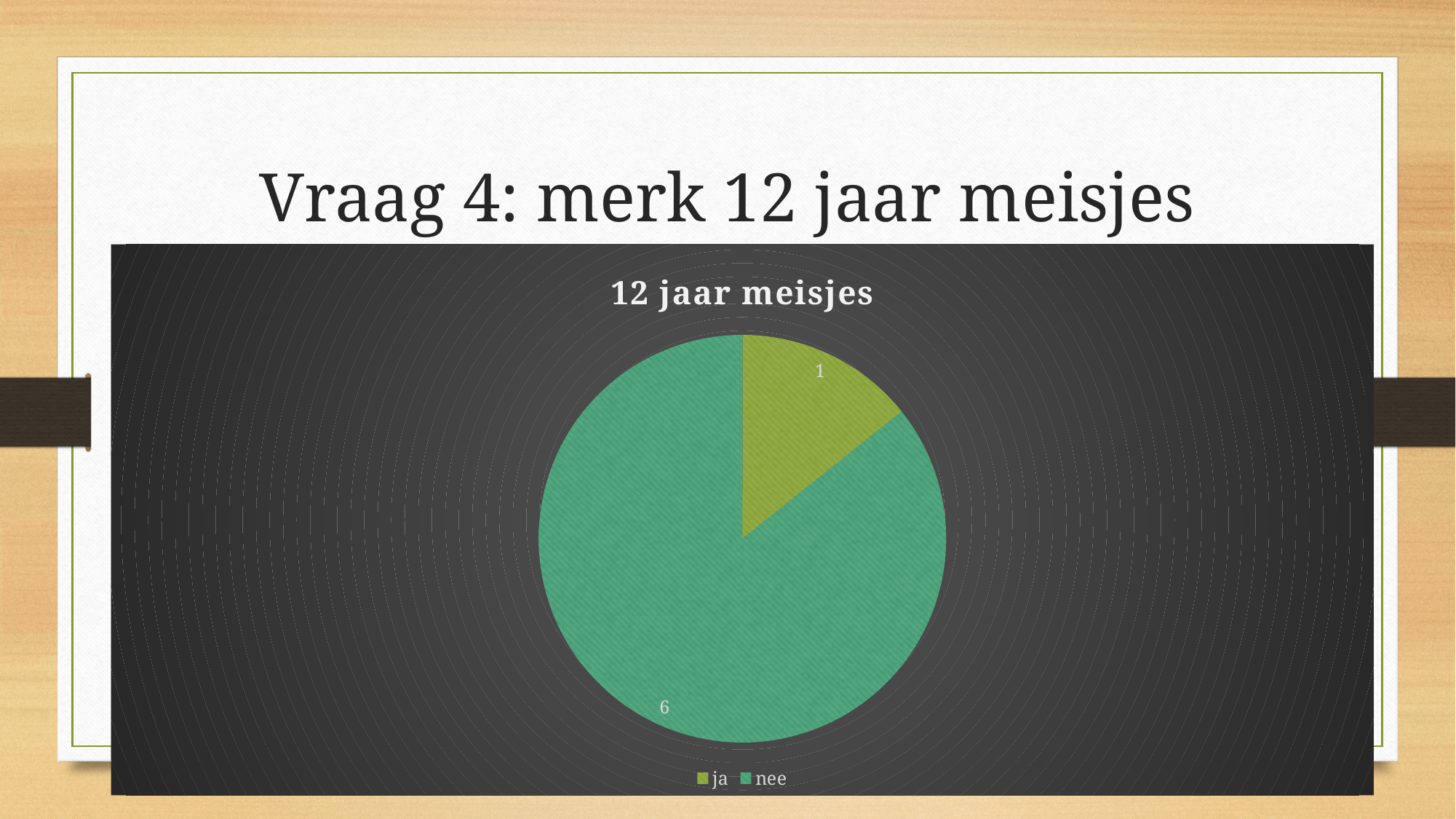
What is the difference between the values for "nee" and "ja"? 5 What is the value for "ja"? 1 Which category has the smallest slice? ja What is the total of all slices in the pie chart? 7 How many entries does the legend list? 2 What kind of chart is shown on the slide? pie chart What is the title of the chart? 12 jaar meisjes Which is larger, the value for "ja" or the value for "nee"? nee Which category has the largest slice? nee How many categories does the pie chart have? 2 What is the value for "nee"? 6 Which legend entry is shown in teal green? nee